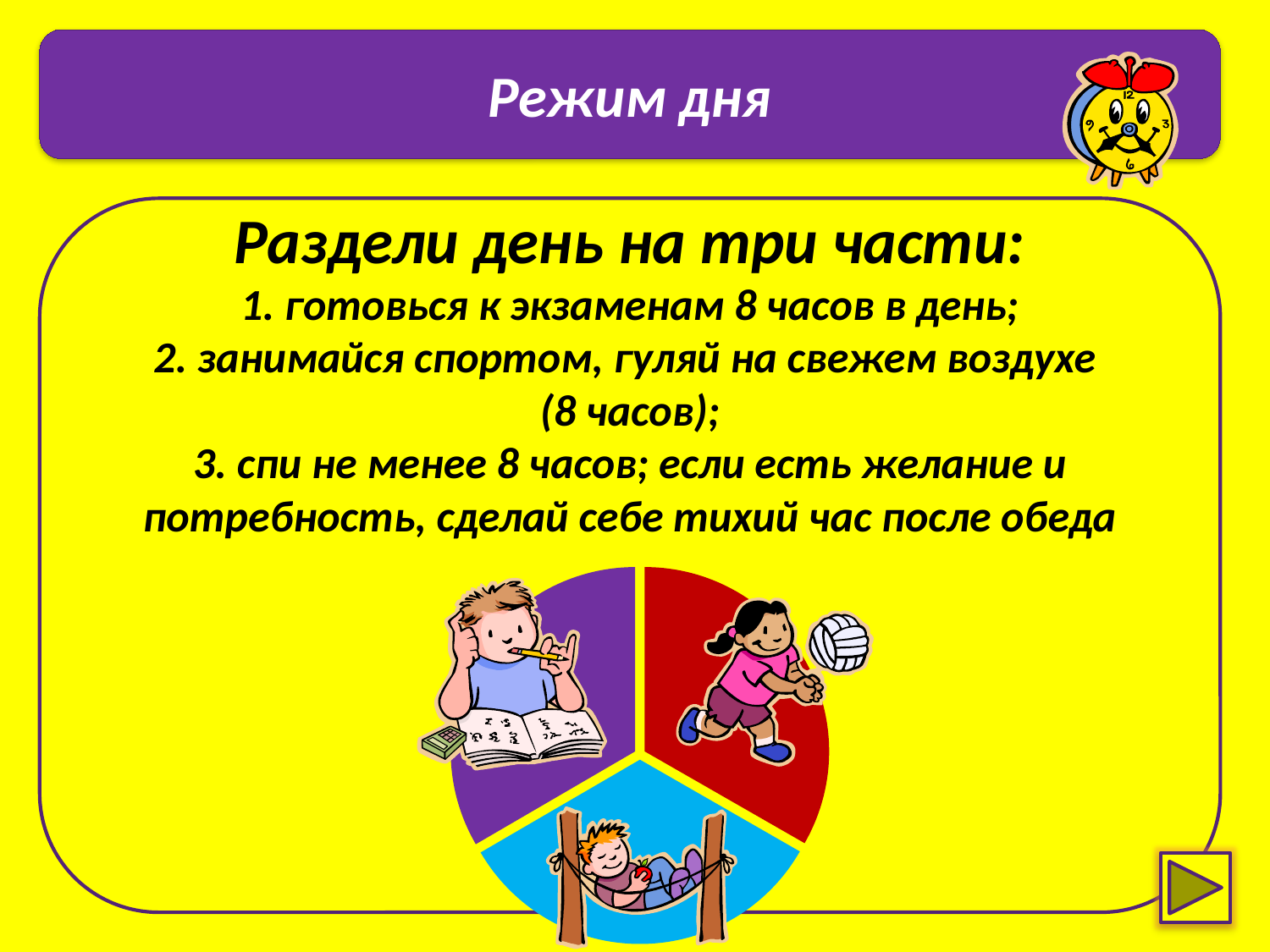
What colour is the pie slice that shows the child sleeping in a hammock? blue How many slices does the pie chart have? 3 What colour is the pie slice that shows the boy studying with a book? purple According to the slide text, how many hours are given to sport and walking in the fresh air, shown by the red slice? 8 часов What kind of chart is shown at the bottom of the slide? pie chart According to the slide text, how many hours a day are given to the part of the day shown by the purple slice (exam preparation)? 8 часов